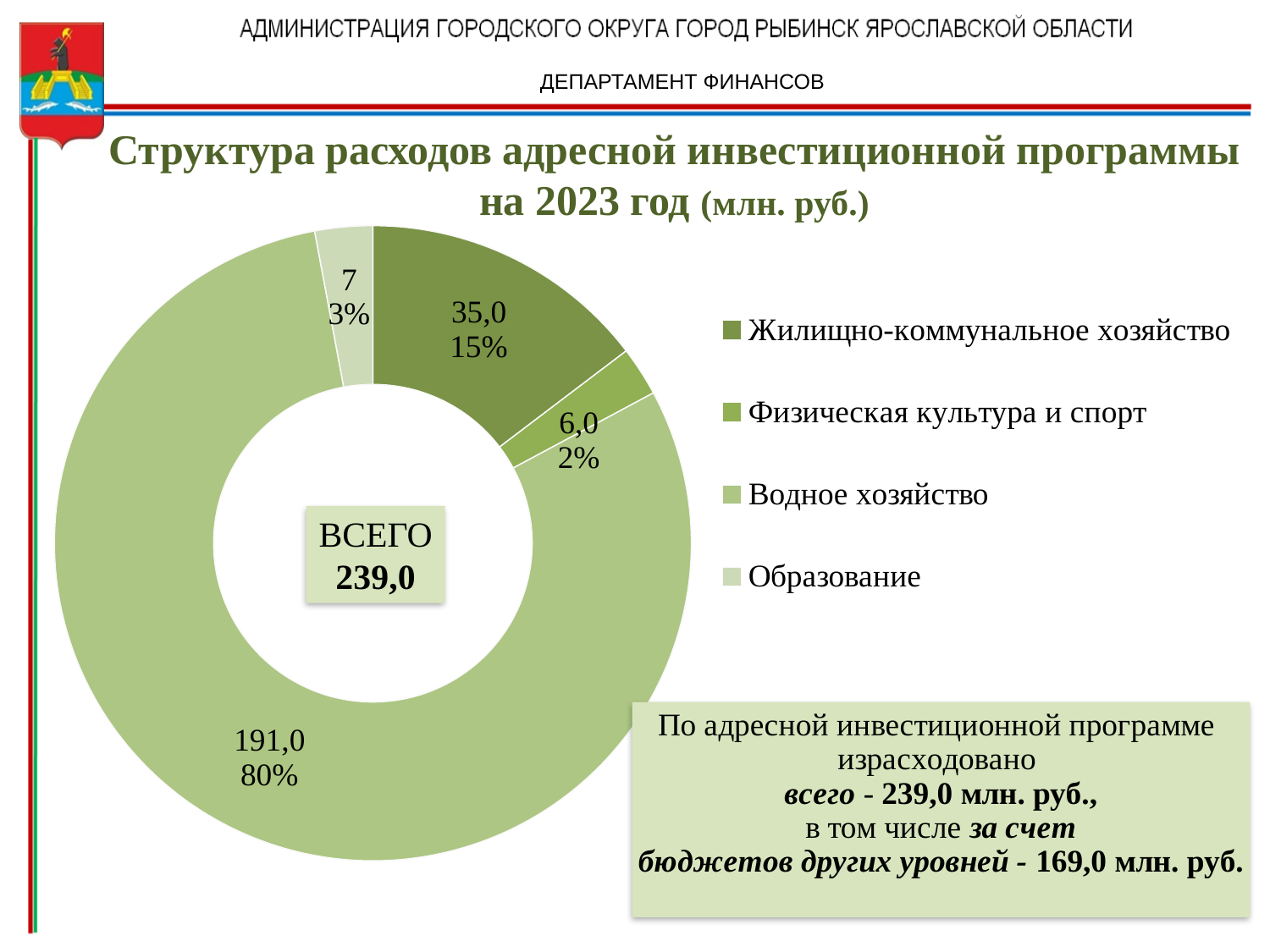
What share of the chart does Водное хозяйство take? 80% Which category has the largest value? Водное хозяйство What kind of chart is shown on the slide? Doughnut (pie) chart Which category has the smallest value? Физическая культура и спорт What is the value for Физическая культура и спорт? 6,0 What share of the chart does Жилищно-коммунальное хозяйство take? 15% What is the difference between the values for Водное хозяйство and Жилищно-коммунальное хозяйство? 156,0 What is the value for Образование? 7 What is the value for Жилищно-коммунальное хозяйство? 35,0 What is the value for Водное хозяйство? 191,0 Which is larger, the value for Образование or the value for Физическая культура и спорт? Образование How many categories does the legend list? 4